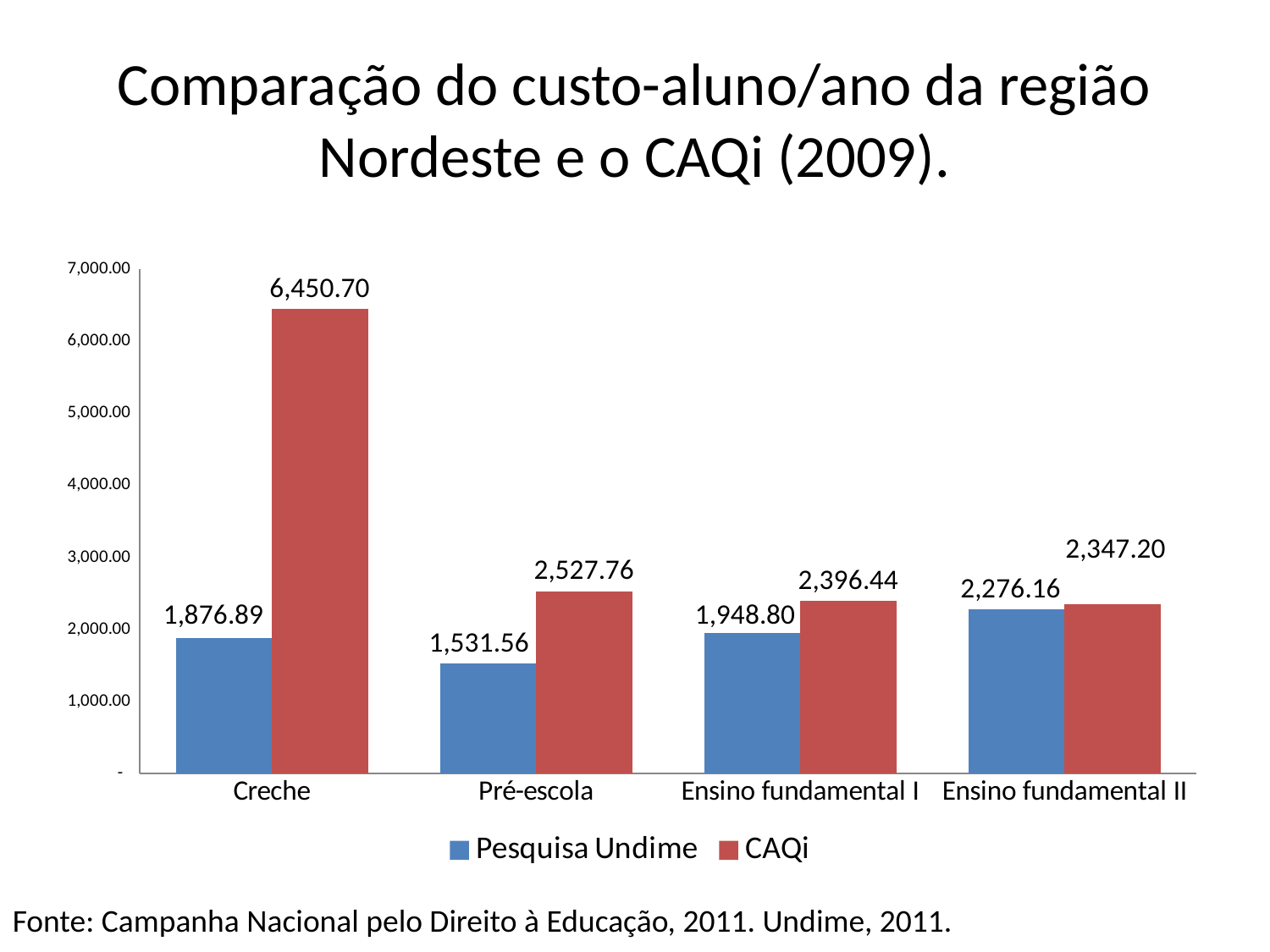
How many series does the legend list? 2 Which category has the lowest Pesquisa Undime value? Pré-escola Which category has the highest CAQi value? Creche What is the Pesquisa Undime value for Pré-escola? 1,531.56 What is the difference between the CAQi and Pesquisa Undime values for Creche? 4,573.81 Which category has the highest Pesquisa Undime value? Ensino fundamental II What is the CAQi value for Ensino fundamental II? 2,347.20 What is the Pesquisa Undime value for Creche? 1,876.89 What is the difference between the CAQi and Pesquisa Undime values for Pré-escola? 996.20 What is the CAQi value for Creche? 6,450.70 How many categories are shown on the x axis? 4 Which is larger for Ensino fundamental I, the Pesquisa Undime value or the CAQi value? CAQi